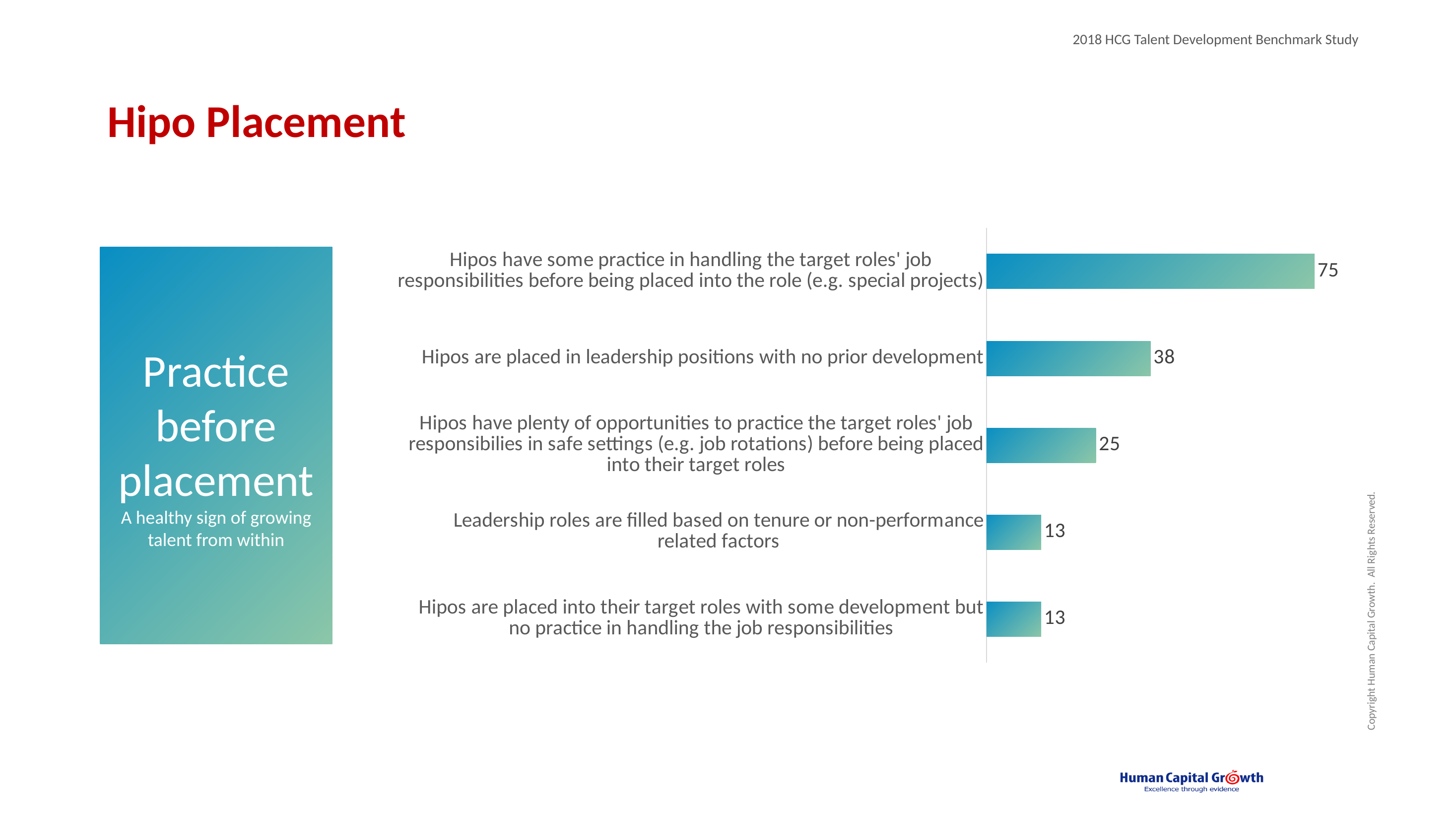
What kind of chart is shown on the slide? Bar chart What is the value for 'Hipos have plenty of opportunities to practice the target roles' job responsibilies in safe settings (e.g. job rotations) before being placed into their target roles'? 25 What is the difference between the value for 'Hipos are placed in leadership positions with no prior development' and the value for 'Leadership roles are filled based on tenure or non-performance related factors'? 25 What is the difference between the value for 'Hipos have some practice in handling the target roles' job responsibilities before being placed into the role (e.g. special projects)' and the value for 'Hipos are placed in leadership positions with no prior development'? 37 What is the value for 'Leadership roles are filled based on tenure or non-performance related factors'? 13 How many categories have a value of 13? 2 What is the value for 'Hipos have some practice in handling the target roles' job responsibilities before being placed into the role (e.g. special projects)'? 75 What is the value for 'Hipos are placed in leadership positions with no prior development'? 38 How many categories are shown in the chart? 5 Which category has the highest value? Hipos have some practice in handling the target roles' job responsibilities before being placed into the role (e.g. special projects) Which is larger: the value for 'Hipos are placed in leadership positions with no prior development' or the value for 'Hipos have plenty of opportunities to practice the target roles' job responsibilies in safe settings (e.g. job rotations) before being placed into their target roles'? Hipos are placed in leadership positions with no prior development What is the title of the slide containing the chart? Hipo Placement